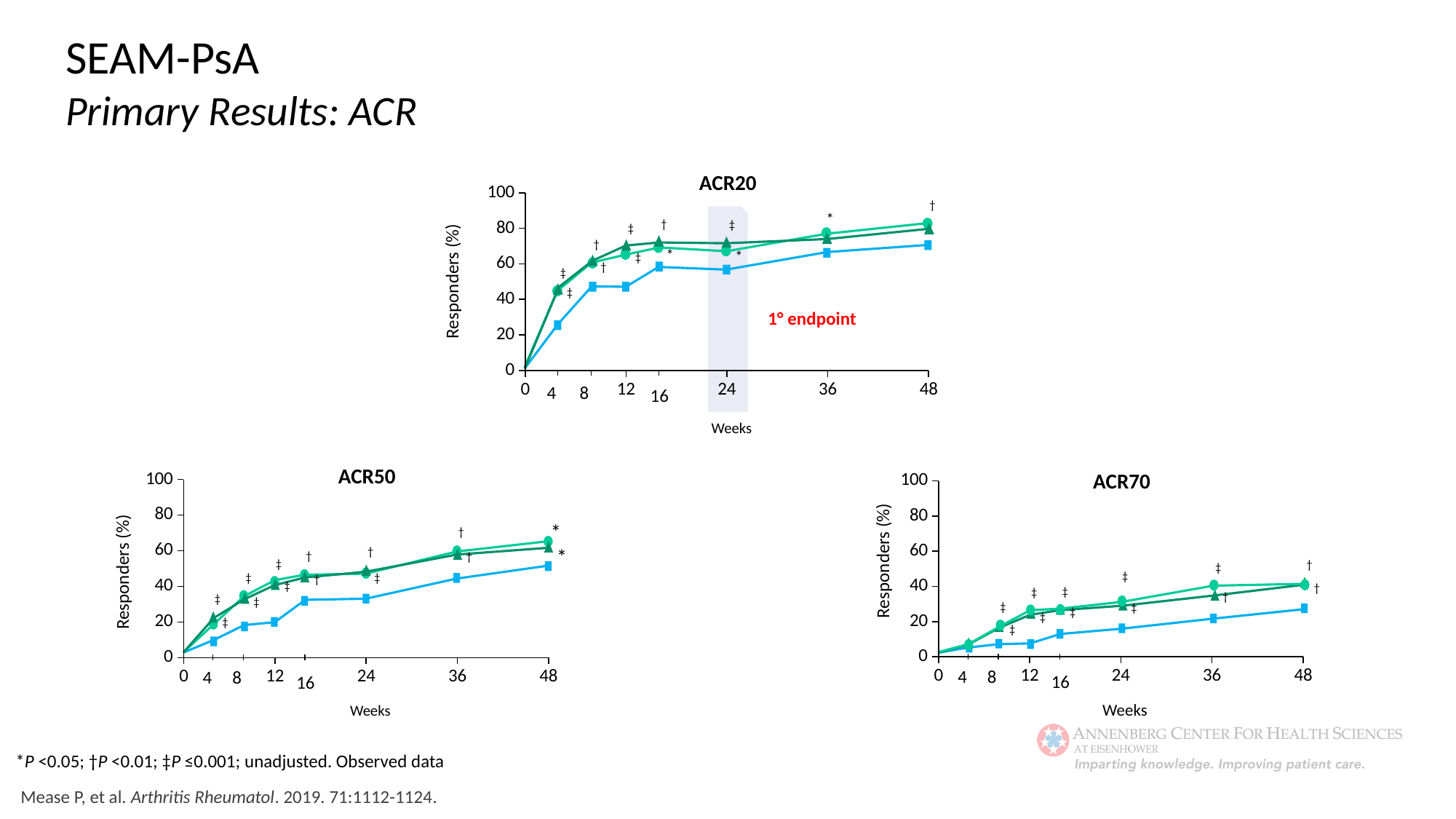
What are the titles of the three charts on the slide? ACR20, ACR50, ACR70 In the ACR20 chart, at which week is the 1° endpoint marked? 24 How many charts are shown on the slide? 3 What kind of chart is the ACR20 chart? line chart In the ACR70 chart, is the value of the green circle series at week 36 greater or less than 20? greater In the ACR20 chart, is the value of the blue square series at week 4 greater or less than 40? less In the ACR70 chart, is the value of the blue square series at week 48 greater or less than 40? less In the ACR20 chart, at week 24, which is higher: the blue square series or the green circle series? green circle series How many week tick labels are shown on the x axis of the ACR70 chart? 8 In the ACR50 chart, do the values of the blue square series rise or fall from week 0 to week 48? rise